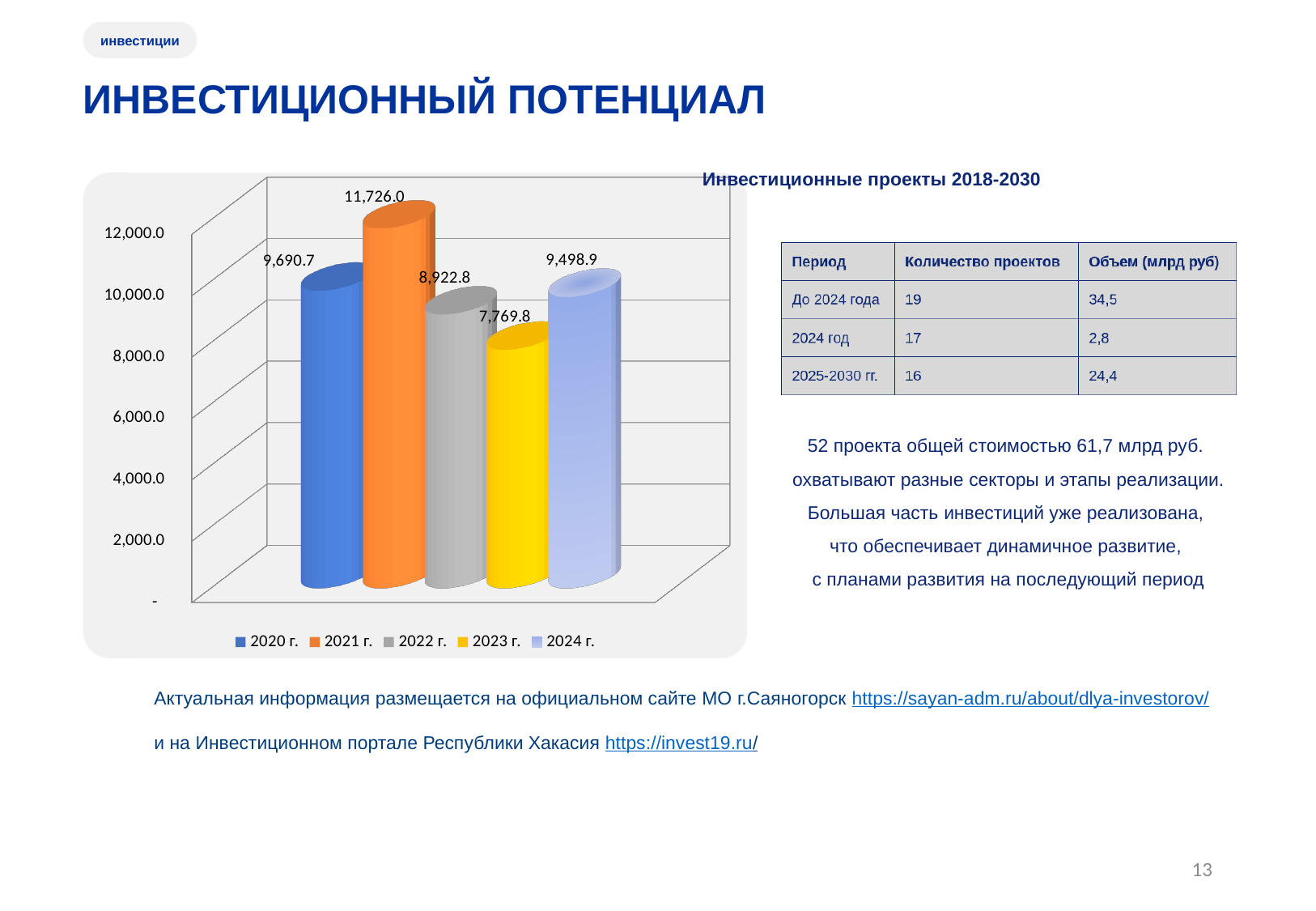
How many bars are plotted on the chart? 5 What is the value shown for 2020 г. on the chart? 9,690.7 Is the value for 2022 г. greater or less than 10,000.0? less What is the value shown for 2021 г. on the chart? 11,726.0 Which is larger, the value for 2020 г. or the value for 2024 г.? 2020 г. What is the difference between the values for 2021 г. and 2023 г.? 3,956.2 What kind of chart is shown on the slide? bar chart What is the value shown for 2024 г. on the chart? 9,498.9 Which year has the highest value on the chart? 2021 г. How many series does the chart legend list? 5 What is the value shown for 2023 г. on the chart? 7,769.8 Which year has the lowest value on the chart? 2023 г.